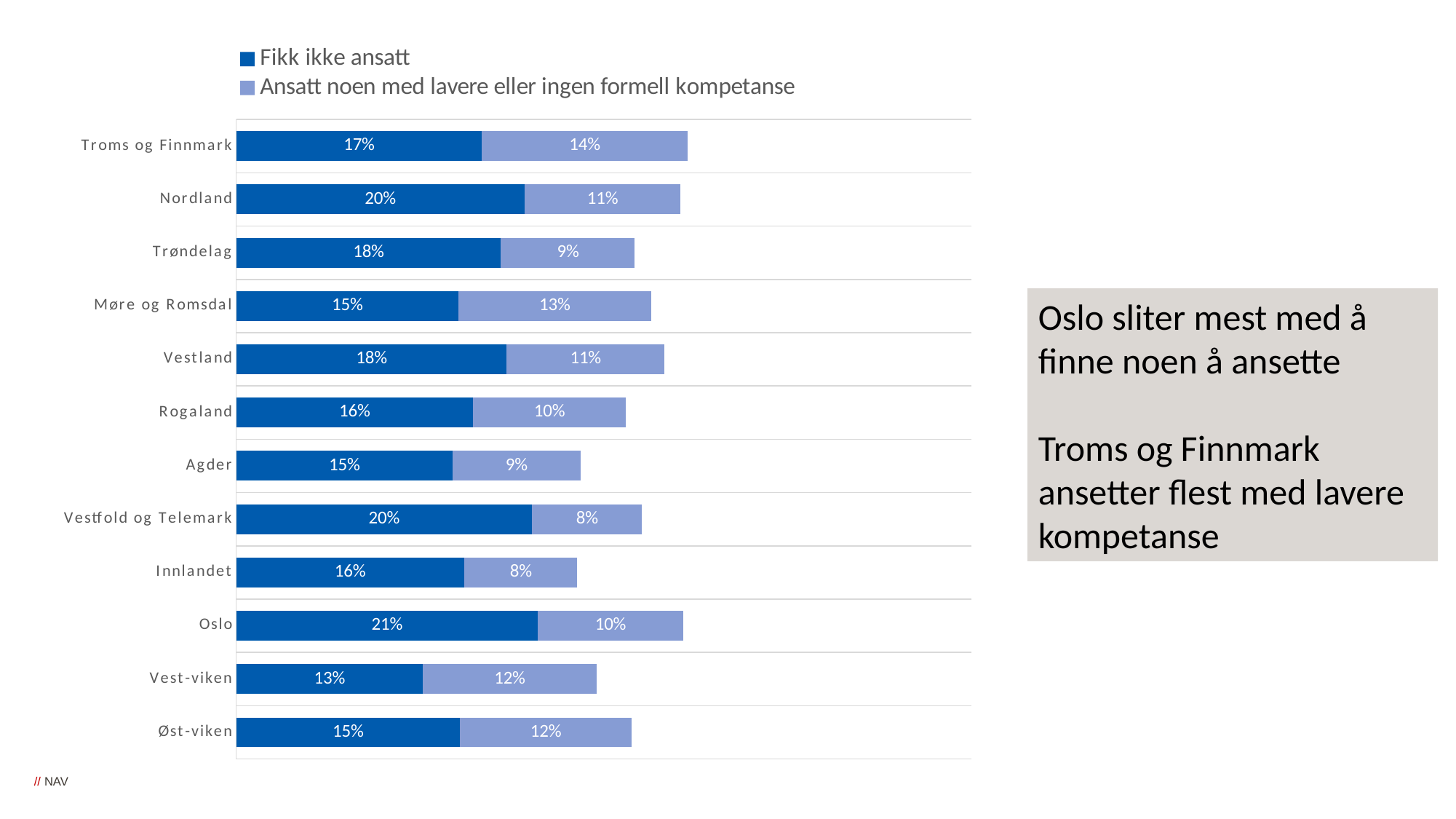
What is the total of the stacked bar for Oslo? 31% Which region has the highest value for "Fikk ikke ansatt"? Oslo Which region has the lowest value for "Fikk ikke ansatt"? Vest-viken What is the value of "Ansatt noen med lavere eller ingen formell kompetanse" for Troms og Finnmark? 14% Which region has the highest value for "Ansatt noen med lavere eller ingen formell kompetanse"? Troms og Finnmark What kind of chart is shown on the slide? Stacked bar chart How many regions are shown in the chart? 12 How many series does the legend list? 2 What is the value of "Fikk ikke ansatt" for Oslo? 21% What is the difference between the "Fikk ikke ansatt" values for Nordland and Trøndelag? 2% What is the value of "Fikk ikke ansatt" for Vest-viken? 13% Which is larger: the "Ansatt noen med lavere eller ingen formell kompetanse" value for Møre og Romsdal or for Rogaland? Møre og Romsdal